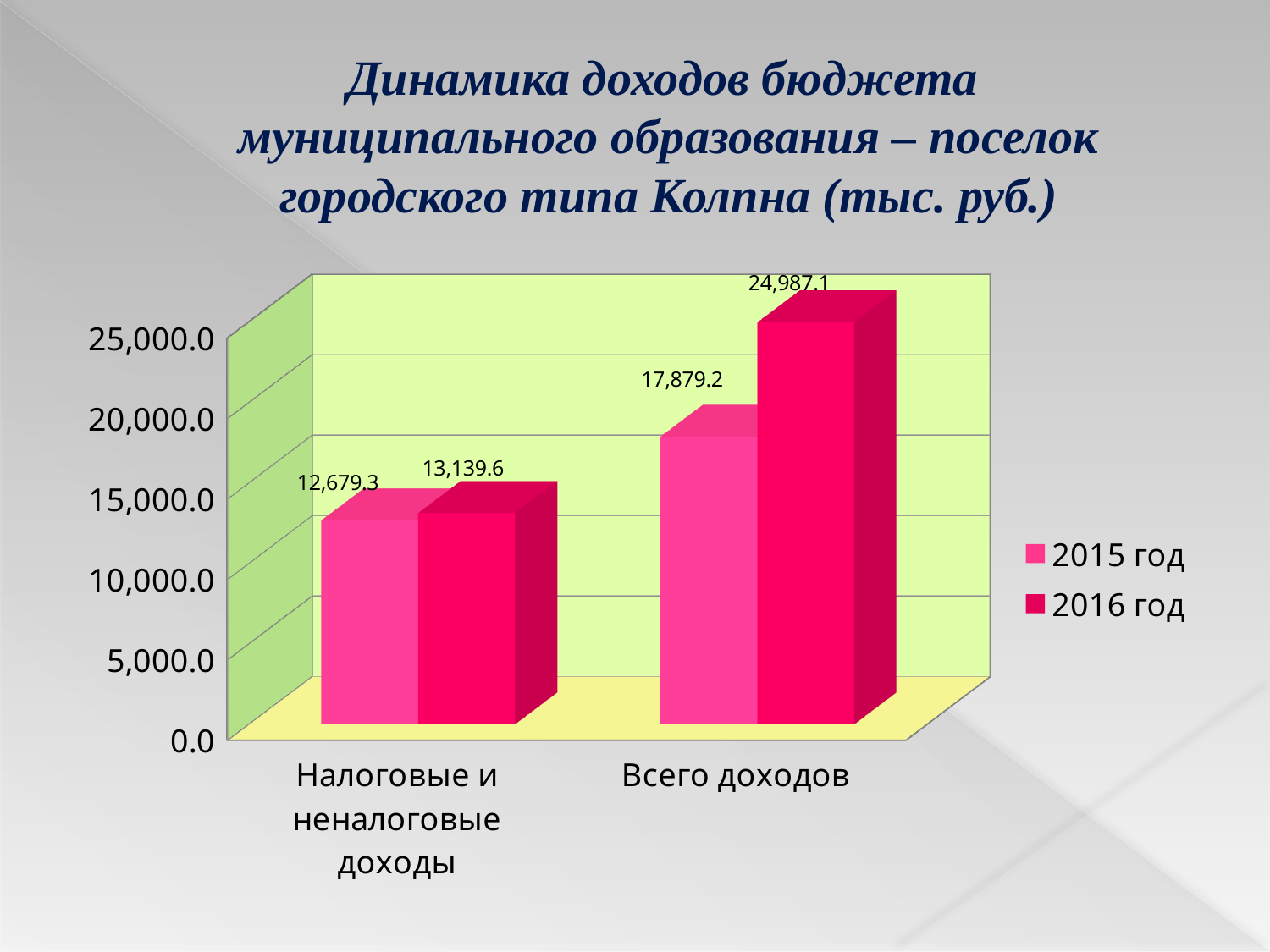
What is the value for 2015 год in the category Налоговые и неналоговые доходы? 12,679.3 What is the value for 2016 год in the category Налоговые и неналоговые доходы? 13,139.6 Which bar has the lowest value on the chart? 2015 год, Налоговые и неналоговые доходы What kind of chart is shown on the slide? Bar chart For Всего доходов, which year has the larger value, 2015 год or 2016 год? 2016 год What is the difference between the 2016 год and 2015 год values for Всего доходов? 7,107.9 What is the difference between the 2016 год and 2015 год values for Налоговые и неналоговые доходы? 460.3 How many series does the legend list? 2 What is the value for 2016 год in the category Всего доходов? 24,987.1 Which bar has the highest value on the chart? 2016 год, Всего доходов How many categories are shown on the x axis? 2 What is the value for 2015 год in the category Всего доходов? 17,879.2